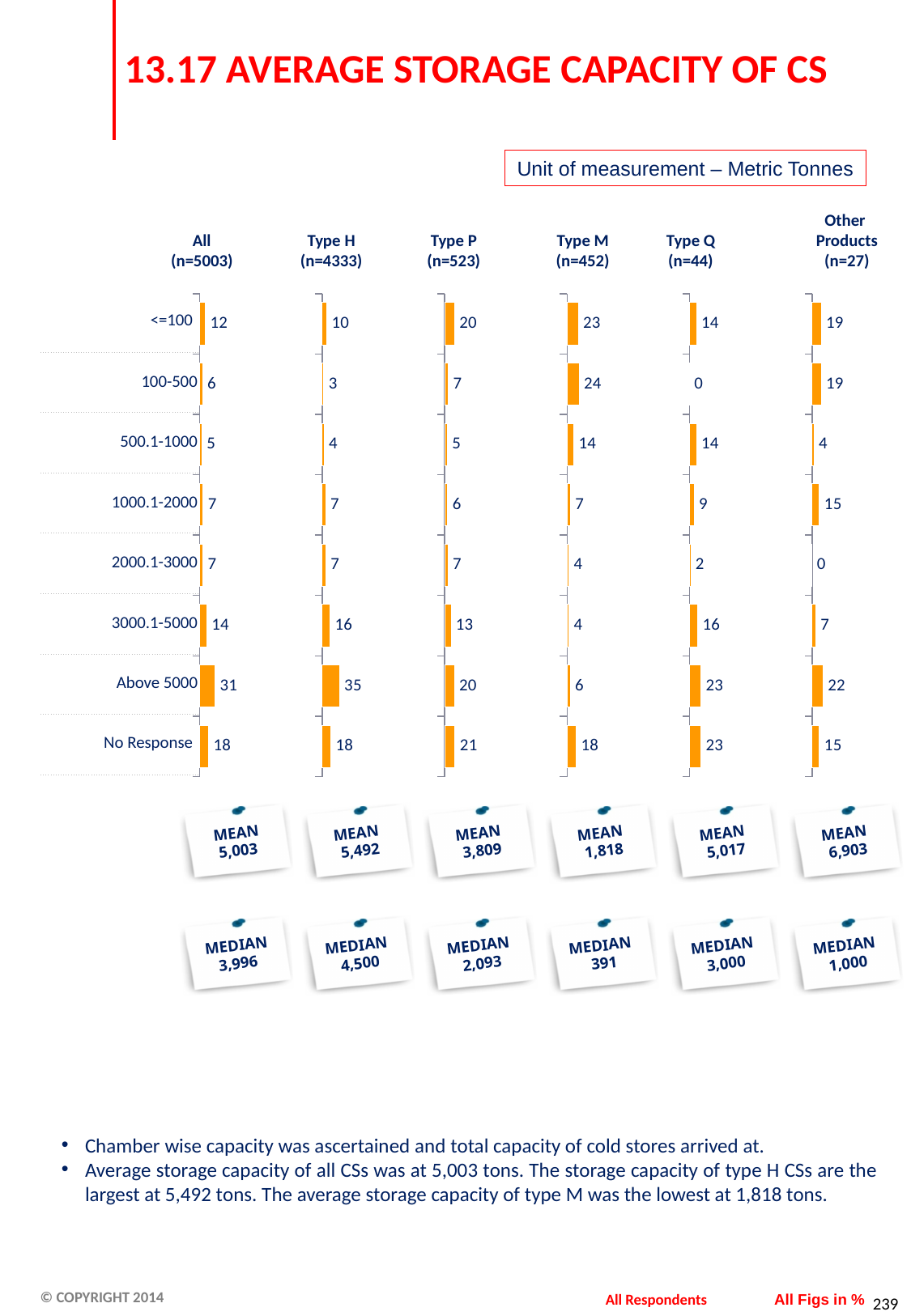
In the 'Type Q (n=44)' chart, which category has the lowest value? 100-500 What kind of chart is the 'Type H (n=4333)' chart? Bar chart In the 'All (n=5003)' chart, what is the value for 'Above 5000'? 31 In the 'Other Products (n=27)' chart, what is the value for '1000.1-2000'? 15 How many categories are shown in the 'All (n=5003)' chart? 8 In the 'Type H (n=4333)' chart, which category has the highest value? Above 5000 In the 'Type H (n=4333)' chart, what is the difference between the values for 'Above 5000' and '3000.1-5000'? 19 What unit of measurement is stated on the slide for the charts? Metric Tonnes In the 'Type M (n=452)' chart, which is larger: the value for '<=100' or the value for 'Above 5000'? <=100 In the 'Other Products (n=27)' chart, which category has the lowest value? 2000.1-3000 In the 'Type P (n=523)' chart, what is the difference between the values for 'No Response' and '<=100'? 1 In the 'Type M (n=452)' chart, what is the value for '100-500'? 24